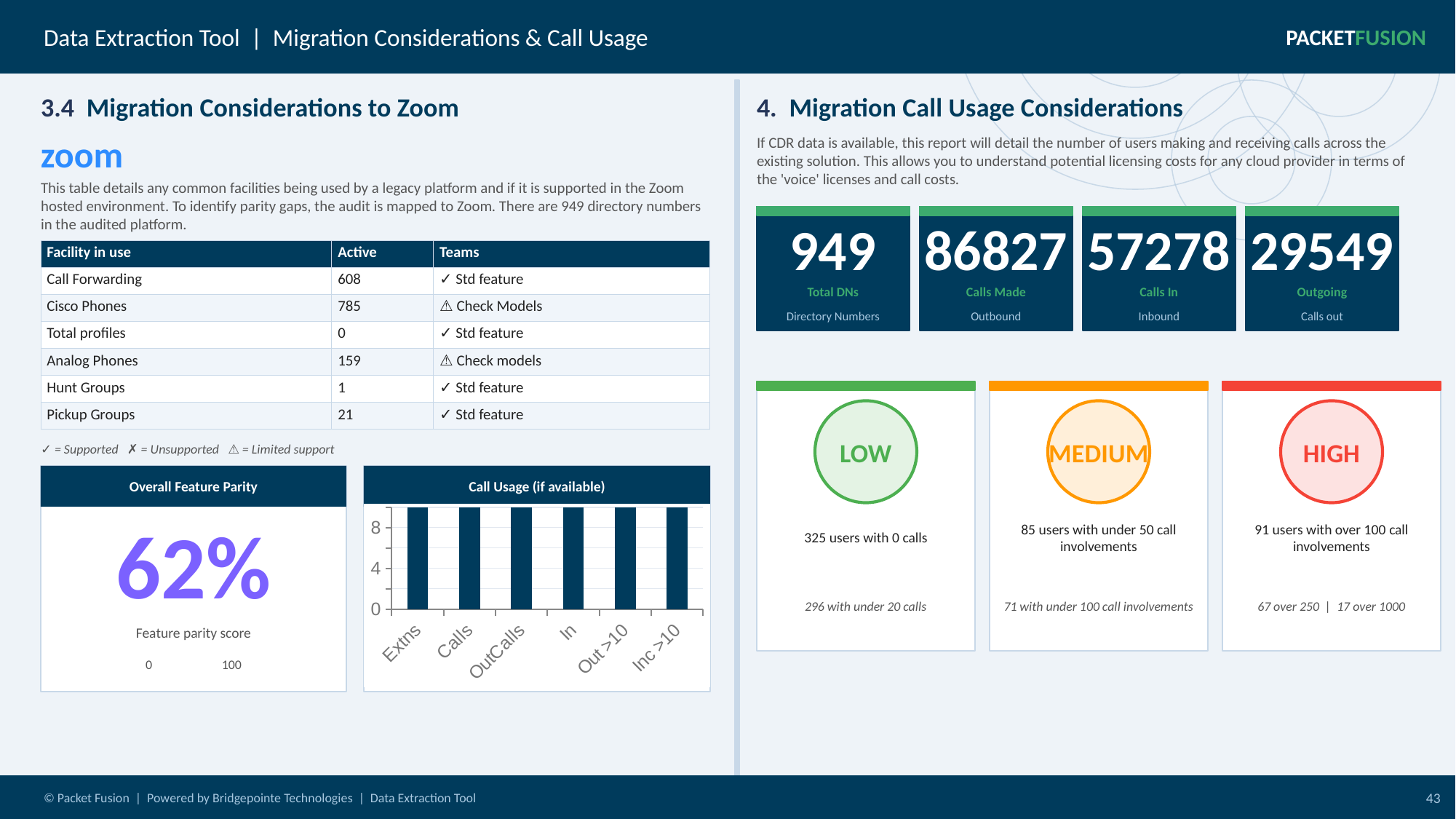
In the "Call Usage (if available)" chart, is the value for Extns greater or less than 8? greater In the "Call Usage (if available)" chart, is the value for In greater or less than 8? greater What is the label of the first category on the x axis of the "Call Usage (if available)" chart? Extns In the "Call Usage (if available)" chart, is the value for Inc >10 greater or less than 4? greater What is the title of the bar chart on the slide? Call Usage (if available) What kind of chart is the "Call Usage (if available)" chart? bar chart What is the highest tick value shown on the y axis of the "Call Usage (if available)" chart? 8 How many categories are shown on the x axis of the "Call Usage (if available)" chart? 6